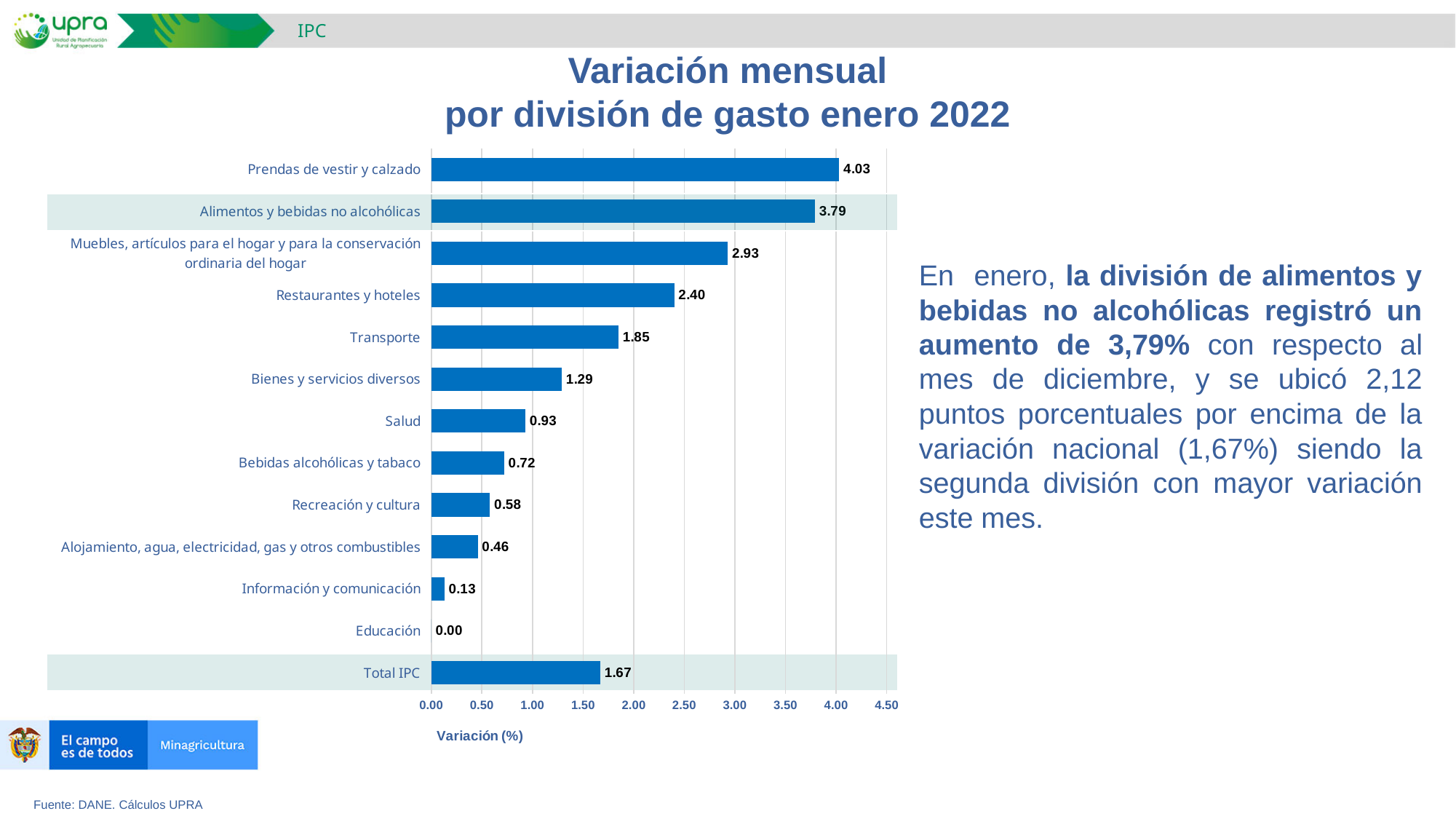
Which division has the lowest monthly variation? Educación What is the value for Total IPC? 1.67 What is the value for Transporte? 1.85 Is the value for Restaurantes y hoteles greater or less than 2.00? greater What is the title of the chart? Variación mensual por división de gasto enero 2022 How many categories are shown in the chart, including Total IPC? 13 Which division has the highest monthly variation? Prendas de vestir y calzado Which is larger, the value for Salud or the value for Bebidas alcohólicas y tabaco? Salud What is the label of the horizontal axis? Variación (%) What kind of chart is shown on the slide? Bar chart What is the difference between the values for Prendas de vestir y calzado and Alimentos y bebidas no alcohólicas? 0.24 What is the value for Alimentos y bebidas no alcohólicas? 3.79